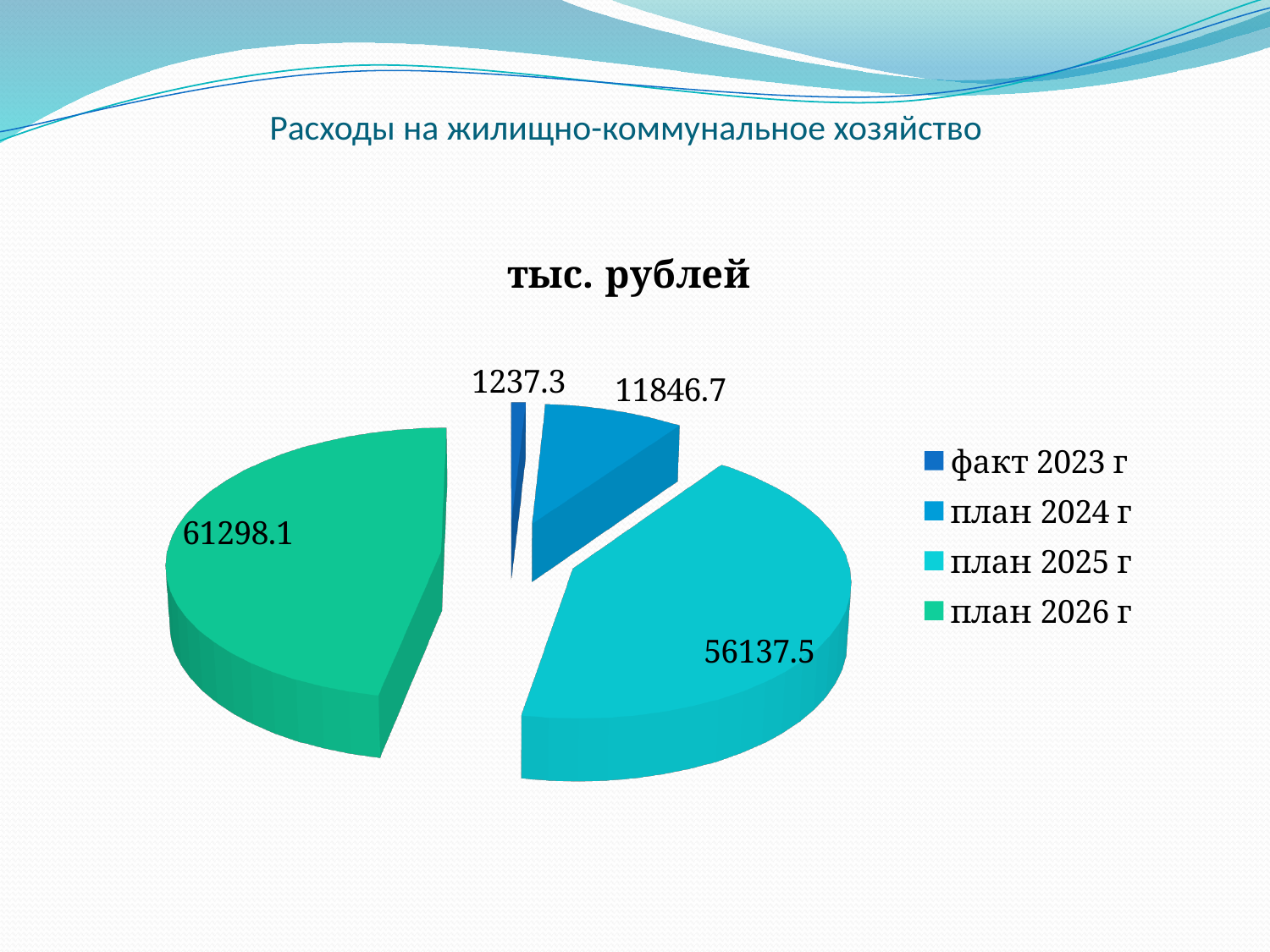
What is the value for факт 2023 г in the pie chart? 1237.3 What is the difference between the values for план 2024 г and факт 2023 г? 10609.4 What is the value for план 2025 г in the pie chart? 56137.5 What is the difference between the values for план 2026 г and план 2025 г? 5160.6 What is the title of the chart? тыс. рублей How many slices does the pie chart have? 4 Which category has the largest slice in the pie chart? план 2026 г What is the value for план 2026 г in the pie chart? 61298.1 What is the value for план 2024 г in the pie chart? 11846.7 Which is larger, the value for план 2024 г or the value for факт 2023 г? план 2024 г Which category has the smallest slice in the pie chart? факт 2023 г What kind of chart is shown on the slide? pie chart